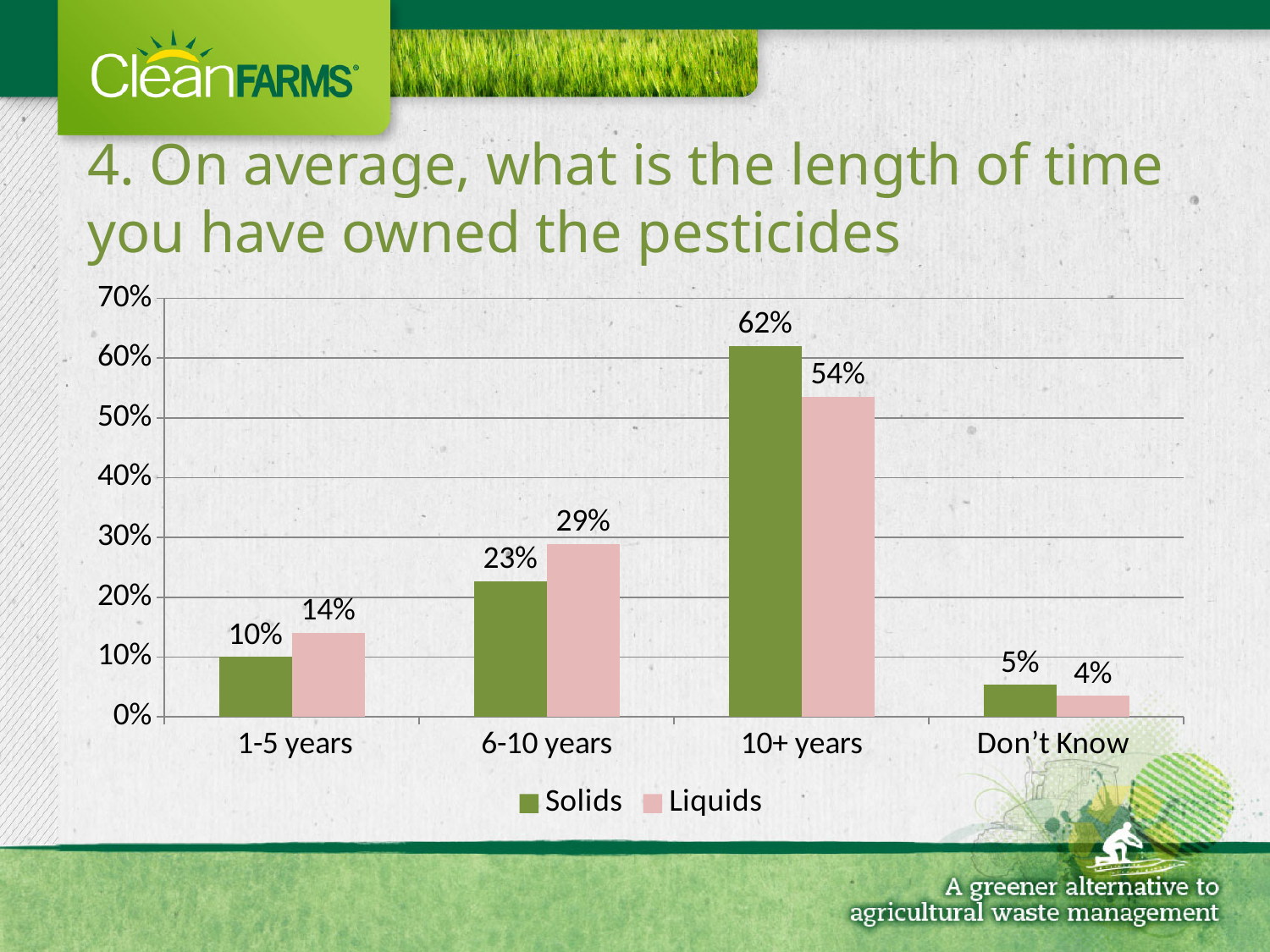
Which category has the lowest value for Liquids? Don't Know What is the difference between the Solids and Liquids values in the 10+ years category? 8% What is the value for Solids in the 10+ years category? 62% Which category has the highest value for Solids? 10+ years What is the value for Liquids in the 6-10 years category? 29% How many series does the legend list? 2 What colour are the Liquids bars? pink How many categories are shown on the x axis? 4 In the 1-5 years category, which series has the larger value, Solids or Liquids? Liquids What kind of chart is shown on the slide? bar chart Is the value for Solids in the 6-10 years category greater or less than 20%? greater What is the value for Liquids in the Don't Know category? 4%